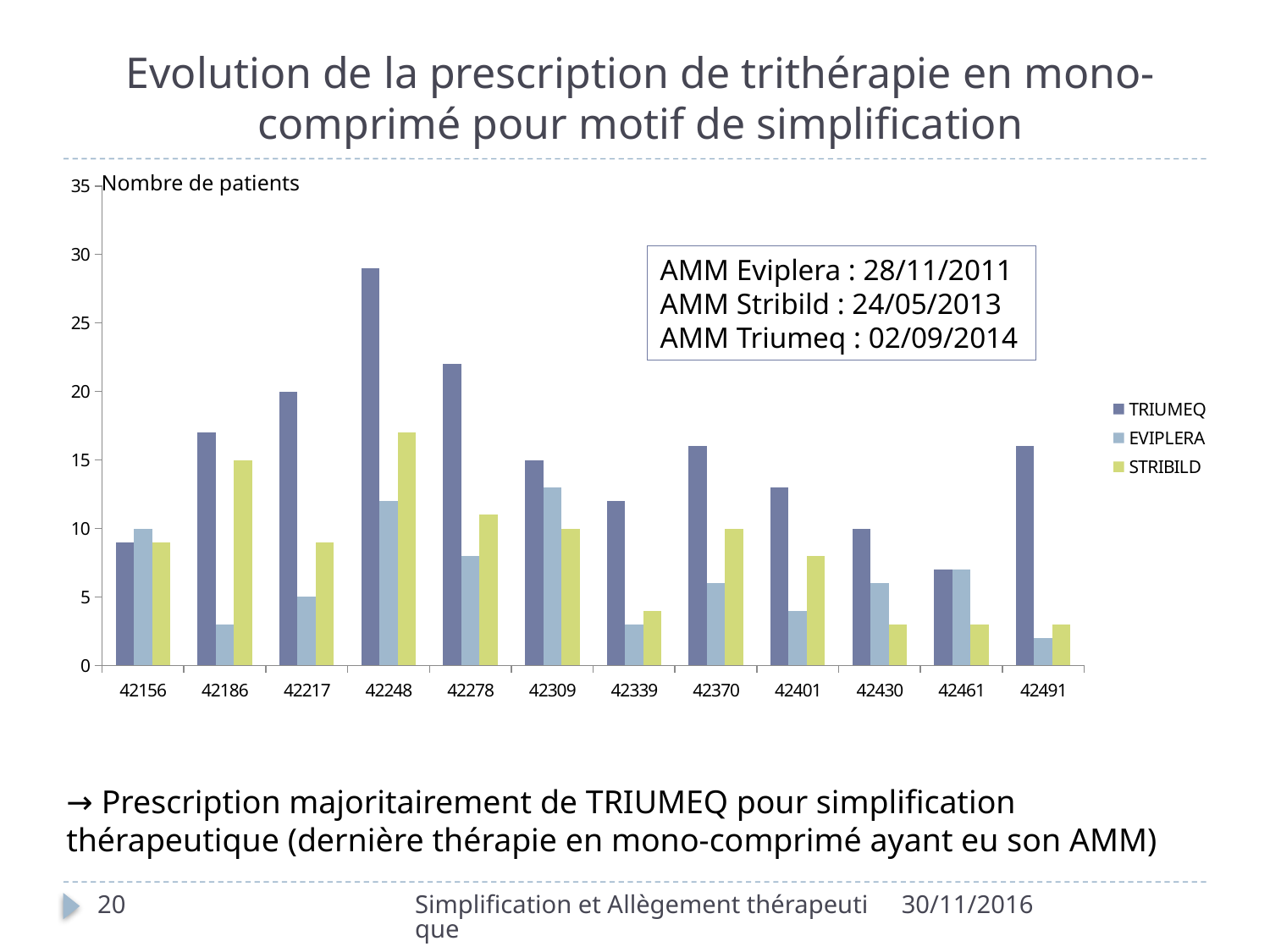
Which is larger at 42186, the TRIUMEQ value or the STRIBILD value? TRIUMEQ Do the TRIUMEQ values rise or fall from 42248 to 42339? fall What kind of chart is shown on the slide? bar chart At which category is the TRIUMEQ value highest? 42248 Which is larger for TRIUMEQ, the value at 42248 or the value at 42278? 42248 How many categories are shown along the x axis? 12 How many series does the legend list? 3 Is the EVIPLERA value at 42186 greater or less than 5? less Is the TRIUMEQ value at 42248 greater or less than 25? greater Is the STRIBILD value at 42248 greater or less than 15? greater At which category is the TRIUMEQ value lowest? 42461 What label is shown on the y axis of the chart? Nombre de patients